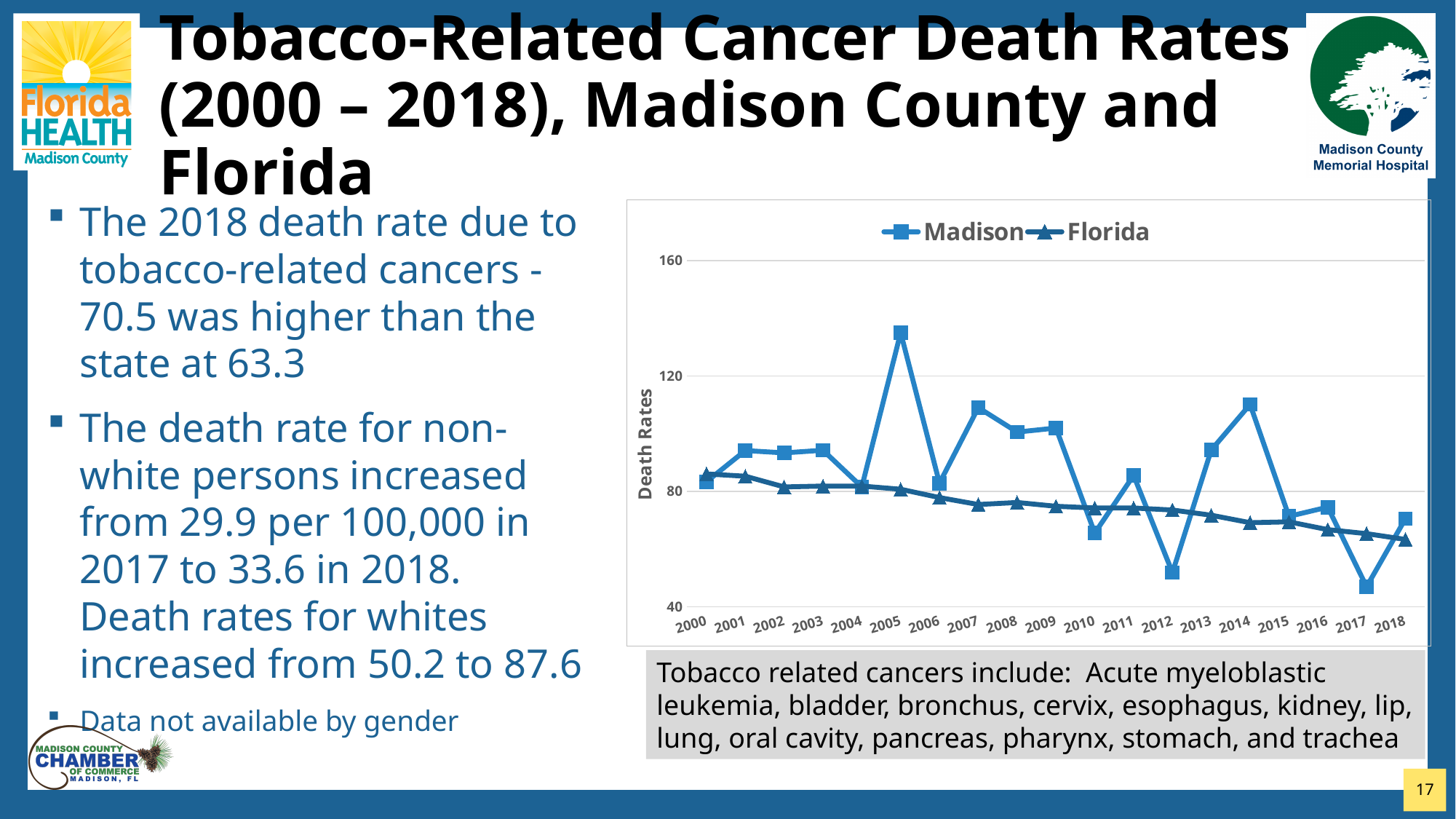
What kind of chart is shown on the slide? line chart Does the Florida series generally rise or fall from 2000 to 2018? fall Which two series are listed in the chart legend? Madison and Florida In which year does the Madison series reach its lowest value? 2017 Is the Florida value for 2018 greater or less than 80? less What is the label on the vertical axis of the chart? Death Rates How many years are plotted along the x axis of the chart? 19 In which year does the Madison series reach its highest value? 2005 In 2005, which series has the larger value, Madison or Florida? Madison Is the Madison value for 2005 greater or less than 120? greater Is the Madison value for 2017 greater or less than 80? less How many series does the chart legend list? 2